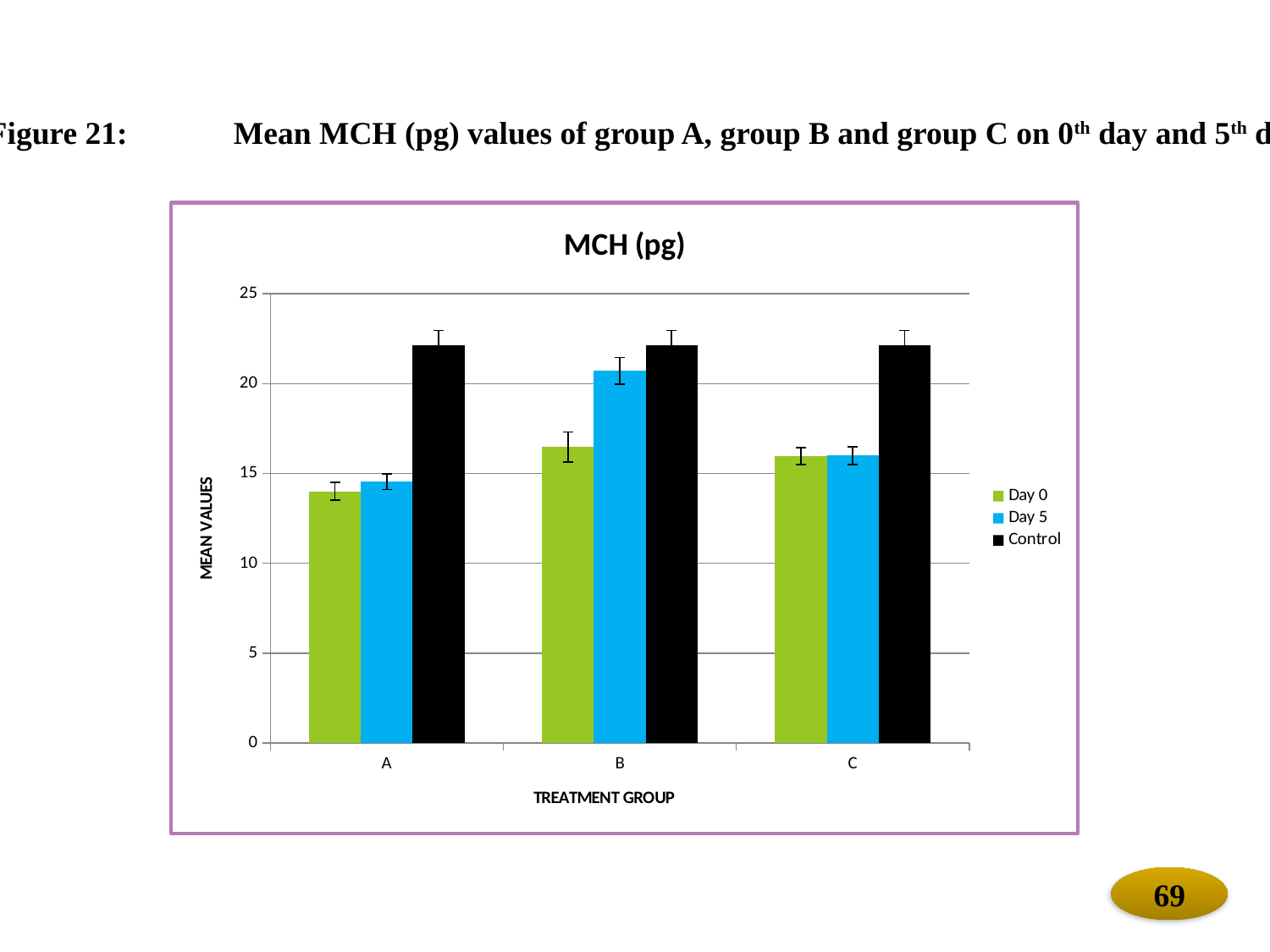
Is the Day 0 value for treatment group A greater or less than 15? less How many series does the legend list? 3 What kind of chart is shown on the slide? Bar chart Which treatment group has the highest Day 5 value? B For treatment group B, which is larger, the Day 0 value or the Day 5 value? Day 5 For treatment group A, which is larger, the Day 0 value or the Control value? Control Is the Day 5 value for treatment group B greater or less than 20? greater How many treatment groups are shown on the x axis? 3 Is the Day 5 value for treatment group C greater or less than 20? less What is the title of the chart? MCH (pg) Which treatment group has the lowest Day 0 value? A